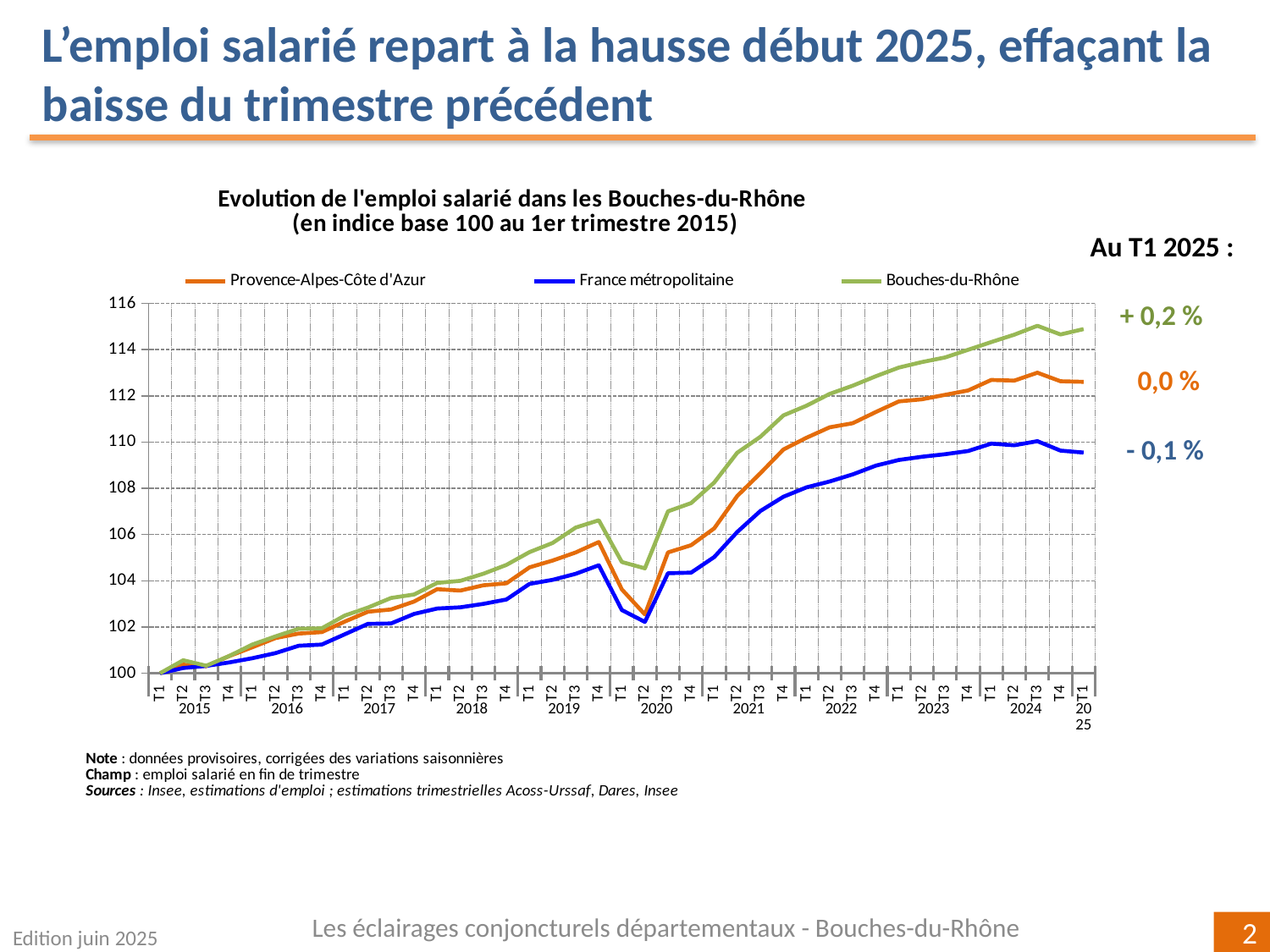
What kind of chart is shown on the slide? line chart What quarterly change is annotated for France métropolitaine at T1 2025? - 0,1 % Which series has the highest value at T1 2025? Bouches-du-Rhône What is the title of the chart? Evolution de l'emploi salarié dans les Bouches-du-Rhône (en indice base 100 au 1er trimestre 2015) At T1 2025, which is larger: Provence-Alpes-Côte d'Azur or France métropolitaine? Provence-Alpes-Côte d'Azur What quarterly change is annotated for Bouches-du-Rhône at T1 2025? + 0,2 % Is the value for France métropolitaine at T1 2025 greater or less than 110? less Is the value for Provence-Alpes-Côte d'Azur at T1 2025 greater or less than 112? greater Do the values for Bouches-du-Rhône generally rise or fall from T1 2015 to T1 2025? rise How many series does the legend list? 3 Which series has the lowest value at T1 2025? France métropolitaine Is the value for Bouches-du-Rhône at T1 2025 greater or less than 114? greater